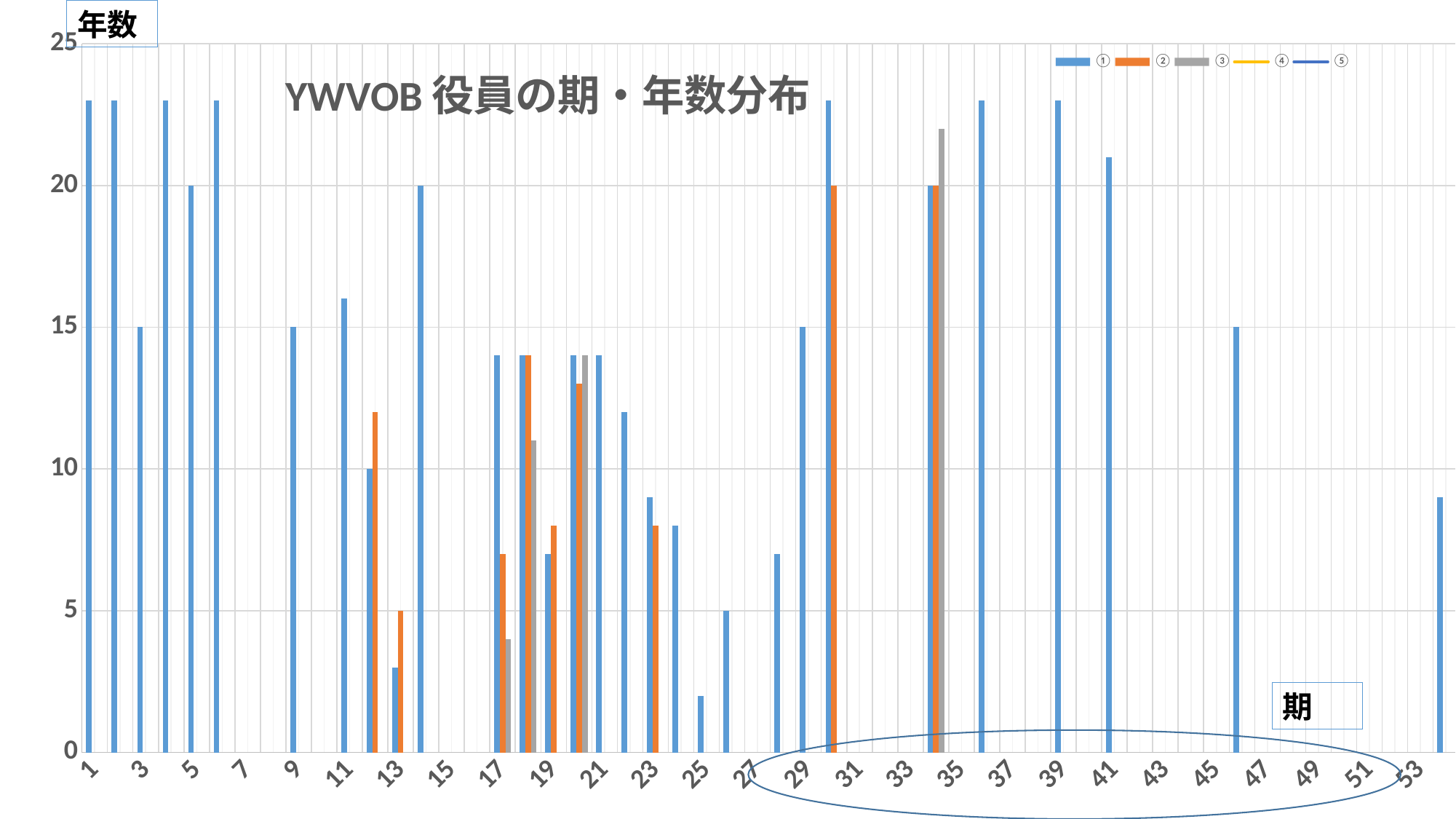
How many series does the legend list? 5 What is the value of the blue (①) bar for 期 3? 15 Which is larger, the blue (①) bar for 期 1 or the blue (①) bar for 期 3? 期 1 Is the value of the blue (①) bar for 期 25 greater or less than 5? less What is the value of the blue (①) bar for 期 5? 20 What is the value of the blue (①) bar for 期 14? 20 What is the title of the chart? YWVOB 役員の期・年数分布 What kind of chart is shown on the slide? bar chart Is the value of the blue (①) bar for 期 1 greater or less than 20? greater At 期 12, which is larger, the blue (①) bar or the orange (②) bar? the orange (②) bar What is the value of the blue (①) bar for 期 26? 5